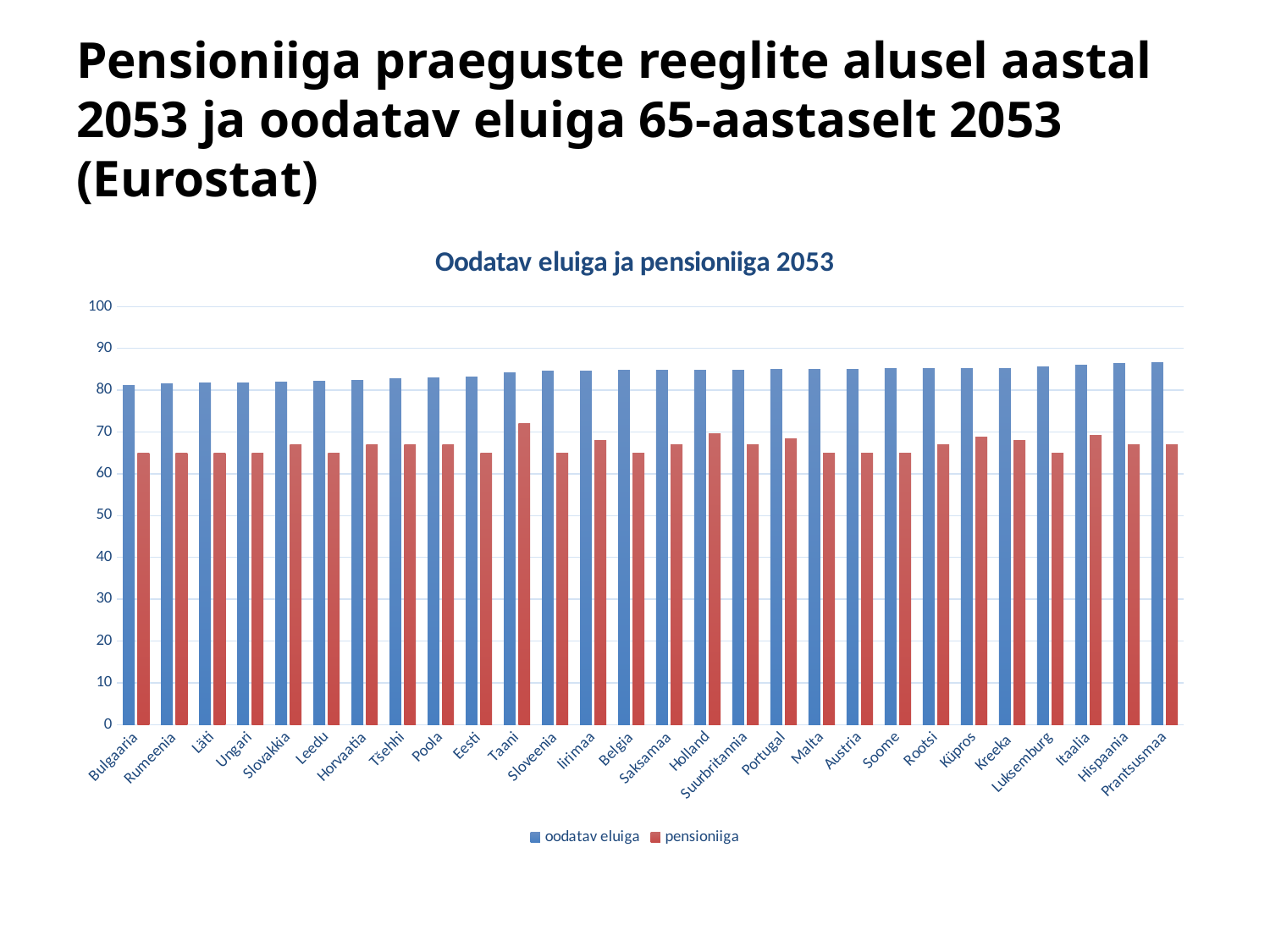
Is the pensioniiga value for Bulgaaria greater or less than 70? less Do the oodatav eluiga values rise or fall from left to right along the x axis? rise What kind of chart is shown on the slide? bar chart Which is larger, the pensioniiga value for Taani or for Sloveenia? Taani Which is larger, the oodatav eluiga value for Bulgaaria or for Prantsusmaa? Prantsusmaa Is the pensioniiga value for Taani greater or less than 70? greater Is the oodatav eluiga value for Prantsusmaa greater or less than 90? less What is the title of the chart? Oodatav eluiga ja pensioniiga 2053 How many countries are shown on the x axis of the chart? 28 How many series does the legend list? 2 Which country has the highest pensioniiga value? Taani Which series is shown in red in the chart? pensioniiga